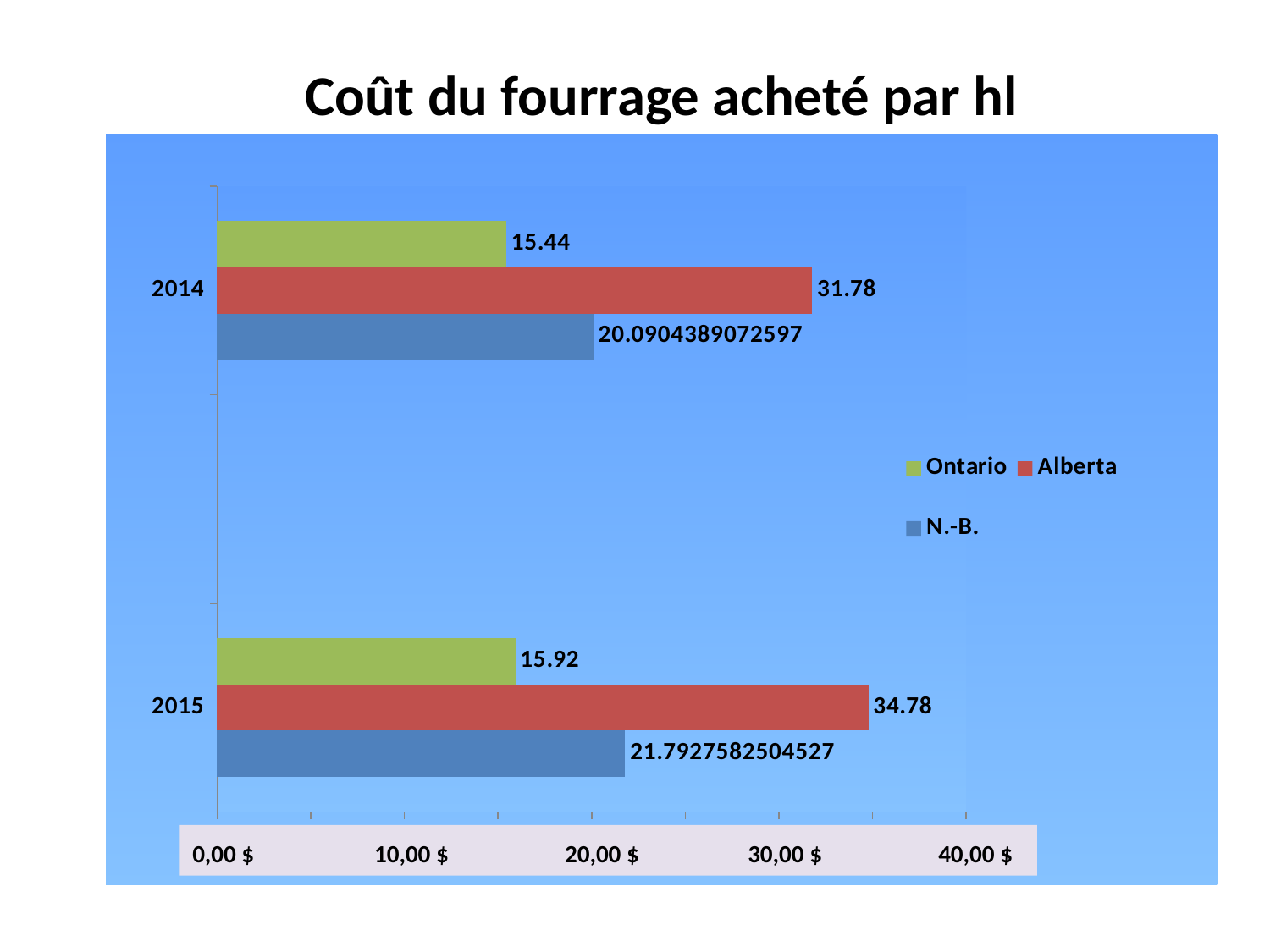
What is the difference between the Ontario values for 2015 and 2014? 0.48 What is the title of the chart? Coût du fourrage acheté par hl Is the value for Alberta in 2014 greater or less than 30,00 $? greater What kind of chart is shown on the slide? bar chart What is the value for N.-B. in 2014? 20.0904389072597 Which series has the highest value in 2015? Alberta Which series has the lowest value in 2014? Ontario How many series does the legend list? 3 What is the value for Ontario in 2014? 15.44 Which is larger, the N.-B. value in 2015 or the Ontario value in 2015? N.-B. value in 2015 What is the value for Alberta in 2015? 34.78 What is the difference between the Alberta values for 2015 and 2014? 3.00